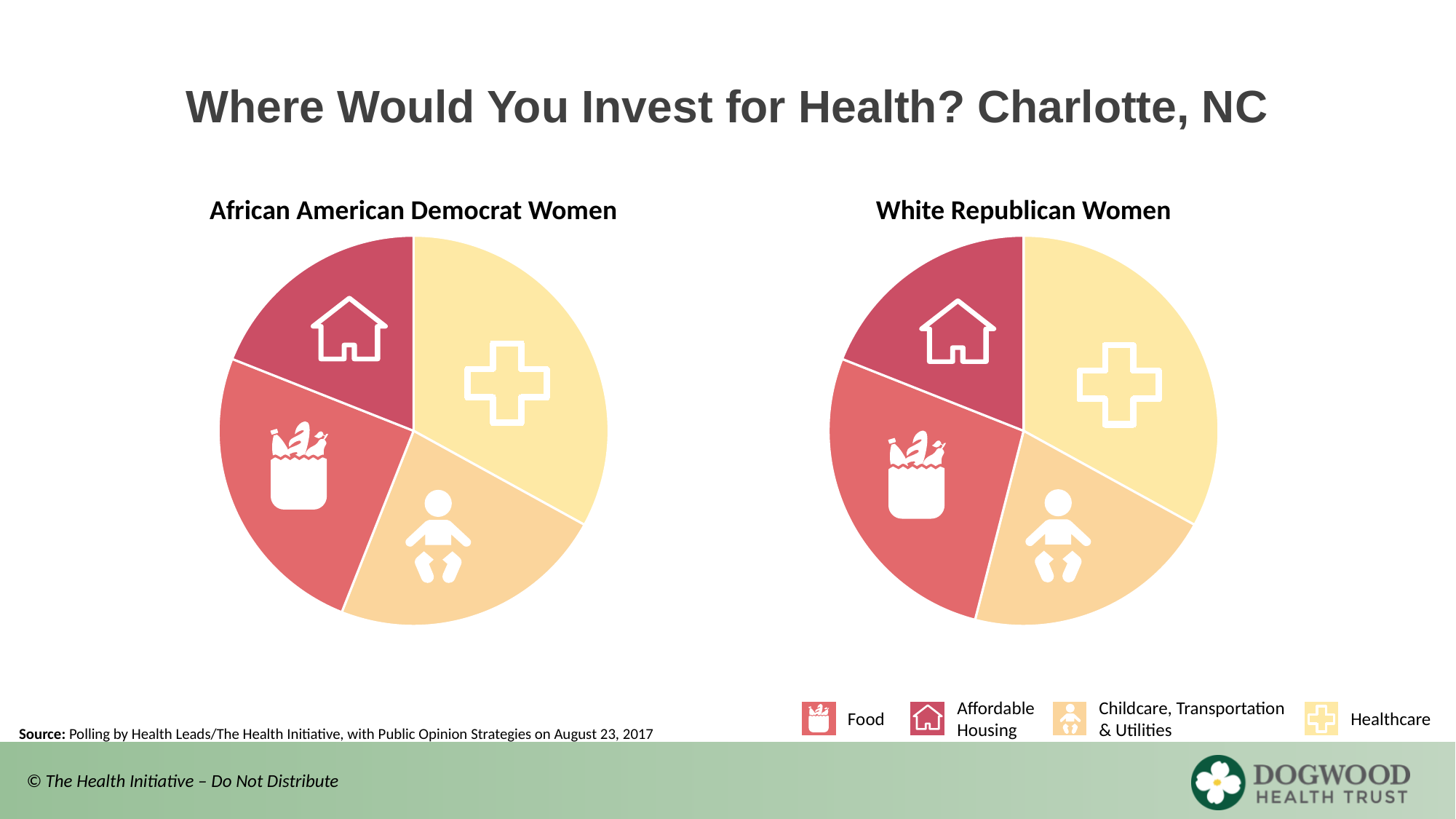
In the African American Democrat Women pie chart, which slice is larger: Healthcare or Food? Healthcare In the White Republican Women pie chart, which category has the smallest slice? Affordable Housing In the White Republican Women pie chart, which category has the largest slice? Healthcare Which category is shown in yellow in the pie charts? Healthcare In the African American Democrat Women pie chart, which category has the smallest slice? Affordable Housing How many slices does the White Republican Women pie chart have? 4 In the White Republican Women pie chart, which slice is larger: Healthcare or Affordable Housing? Healthcare How many categories does the legend list? 4 In the African American Democrat Women pie chart, which category has the largest slice? Healthcare What kind of chart is used for the African American Democrat Women data? Pie chart What is the title of the slide? Where Would You Invest for Health? Charlotte, NC